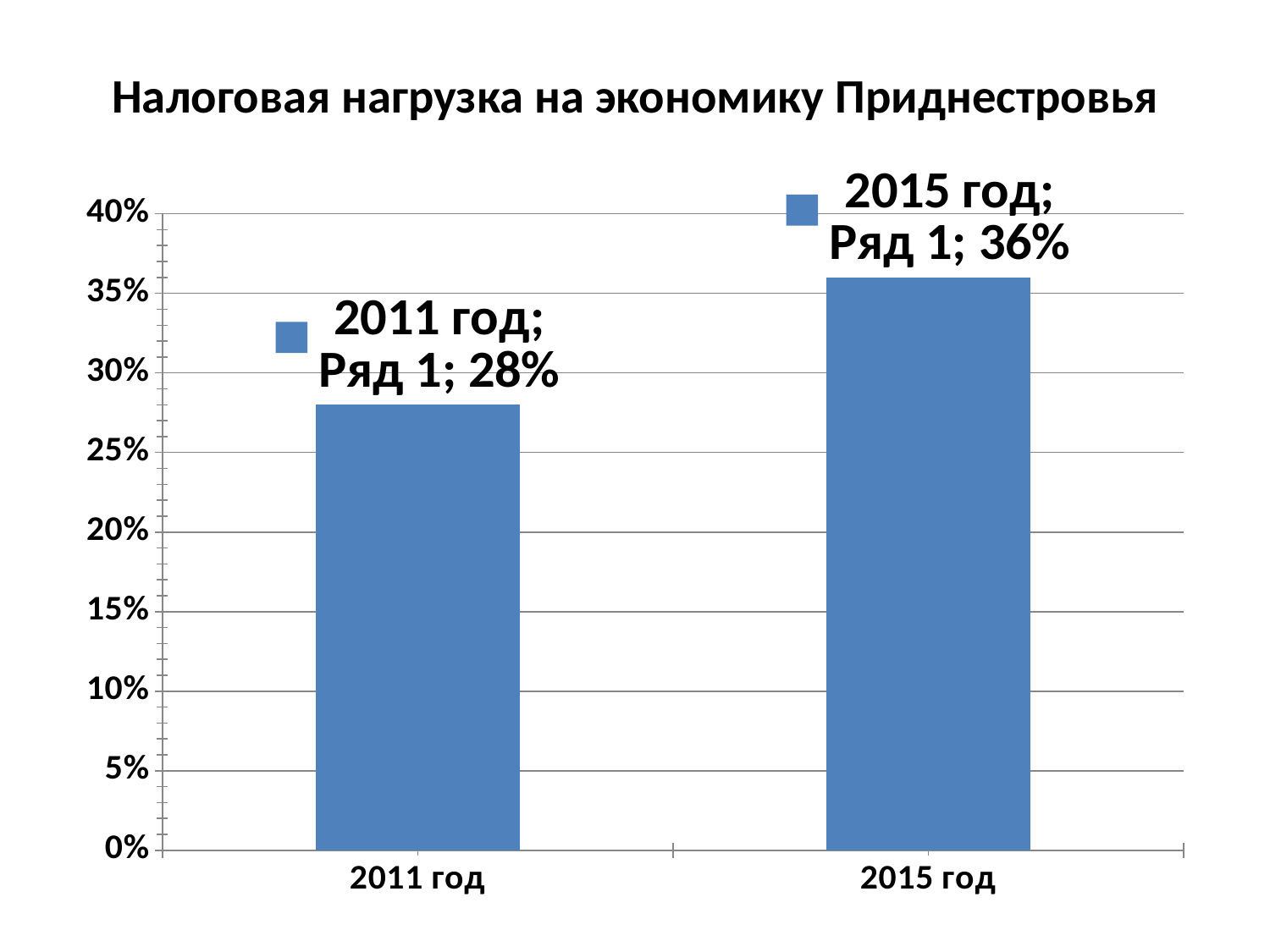
Which category has the lowest value? 2011 год How many categories are shown on the x axis? 2 What is the value for 2015 год? 36% What kind of chart is shown on the slide? bar chart Is the value for 2015 год greater or less than 35%? greater What is the title of the chart? Налоговая нагрузка на экономику Приднестровья Which category has the highest value? 2015 год Which is larger, the value for 2011 год or the value for 2015 год? 2015 год What is the value for 2011 год? 28% What is the difference between the values for 2015 год and 2011 год? 8% Do the values rise or fall from 2011 год to 2015 год? rise Is the value for 2011 год greater or less than 30%? less